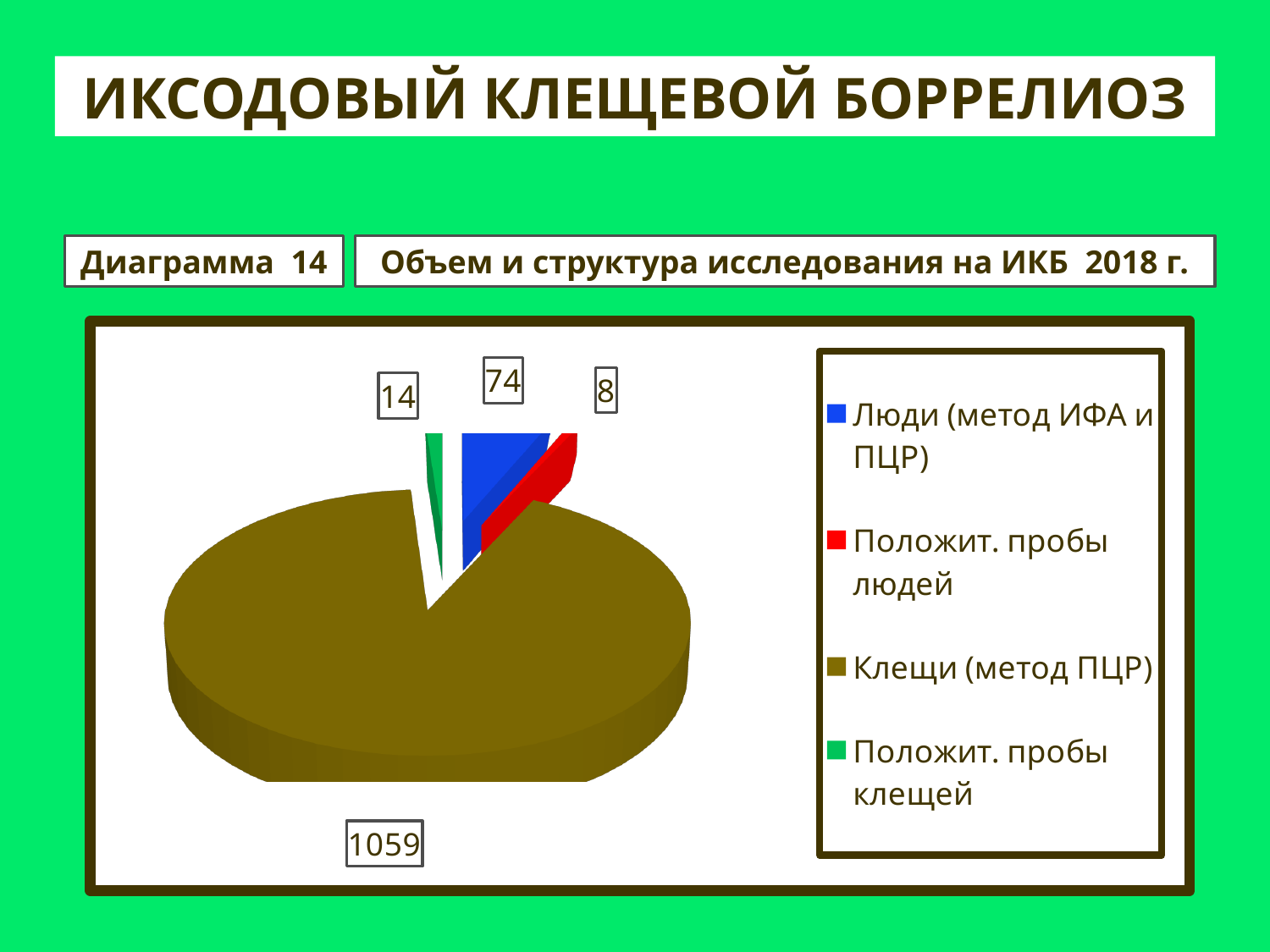
Which is larger: Положит. пробы клещей or Положит. пробы людей? Положит. пробы клещей Which category has the largest slice of the pie? Клещи (метод ПЦР) What is the difference between the values for Клещи (метод ПЦР) and Люди (метод ИФА и ПЦР)? 985 What is the value for Клещи (метод ПЦР)? 1059 How many categories does the pie chart have? 4 Which category has the smallest slice of the pie? Положит. пробы людей What is the title of the chart shown on the slide? Объем и структура исследования на ИКБ 2018 г. What is the difference between the values for Люди (метод ИФА и ПЦР) and Положит. пробы людей? 66 What is the value for Люди (метод ИФА и ПЦР)? 74 What is the value for Положит. пробы людей? 8 What is the value for Положит. пробы клещей? 14 What kind of chart is shown on the slide? Pie chart